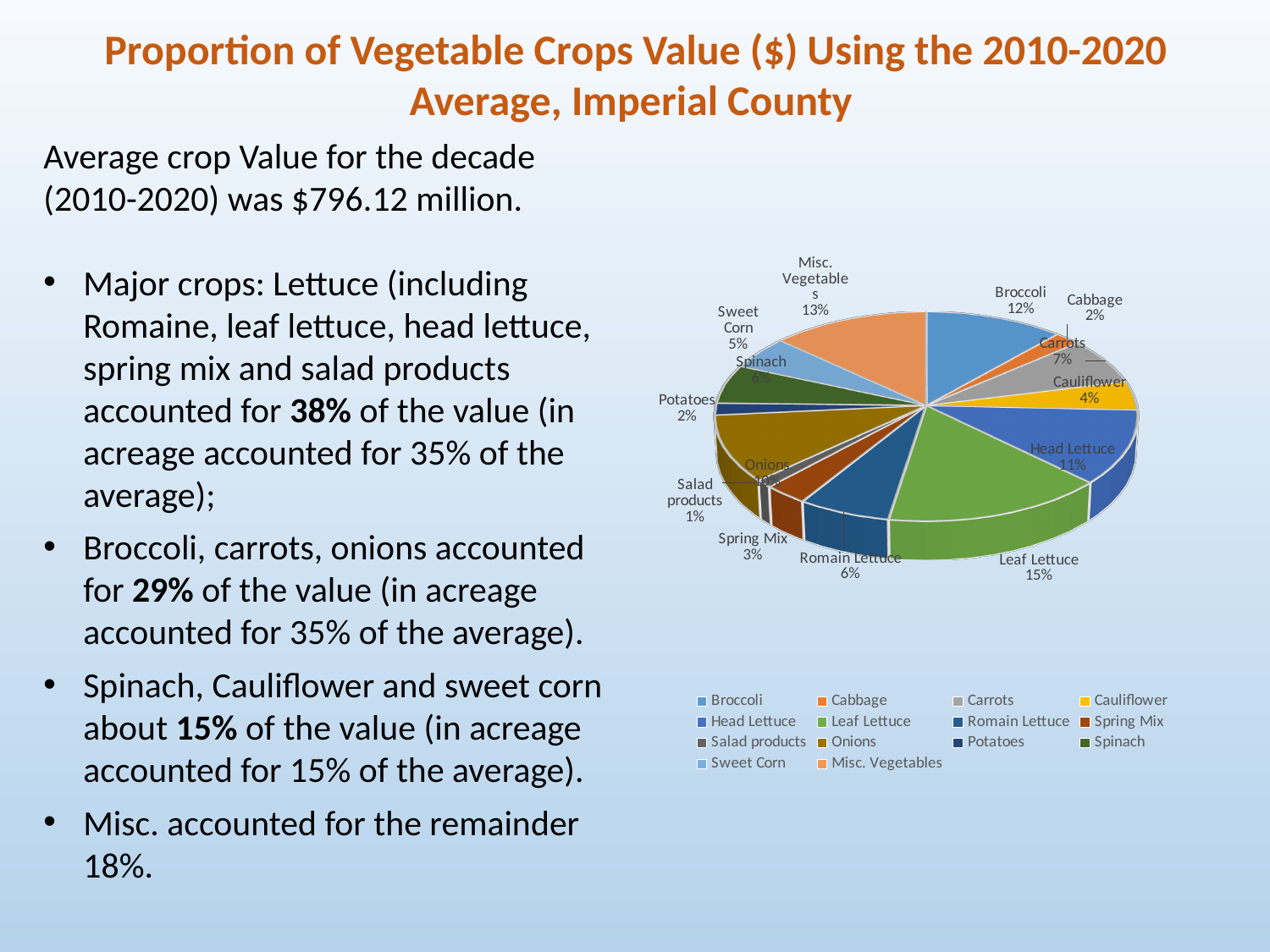
How many crop categories does the legend list? 14 Which has a larger share, Broccoli or Head Lettuce? Broccoli What type of chart is shown on the slide? pie chart What share of the vegetable crops value does Broccoli account for? 12% Which crop has the largest share of the pie chart? Leaf Lettuce How many percentage points larger is the Leaf Lettuce share than the Broccoli share? 3% What percentage of the value is Leaf Lettuce? 15% What percentage is shown for Carrots? 7% Which crop has the smallest share of the pie chart? Salad products What share of the value does Sweet Corn account for? 5% What share does Misc. Vegetables have in the pie chart? 13% What percentage is shown for Head Lettuce? 11%